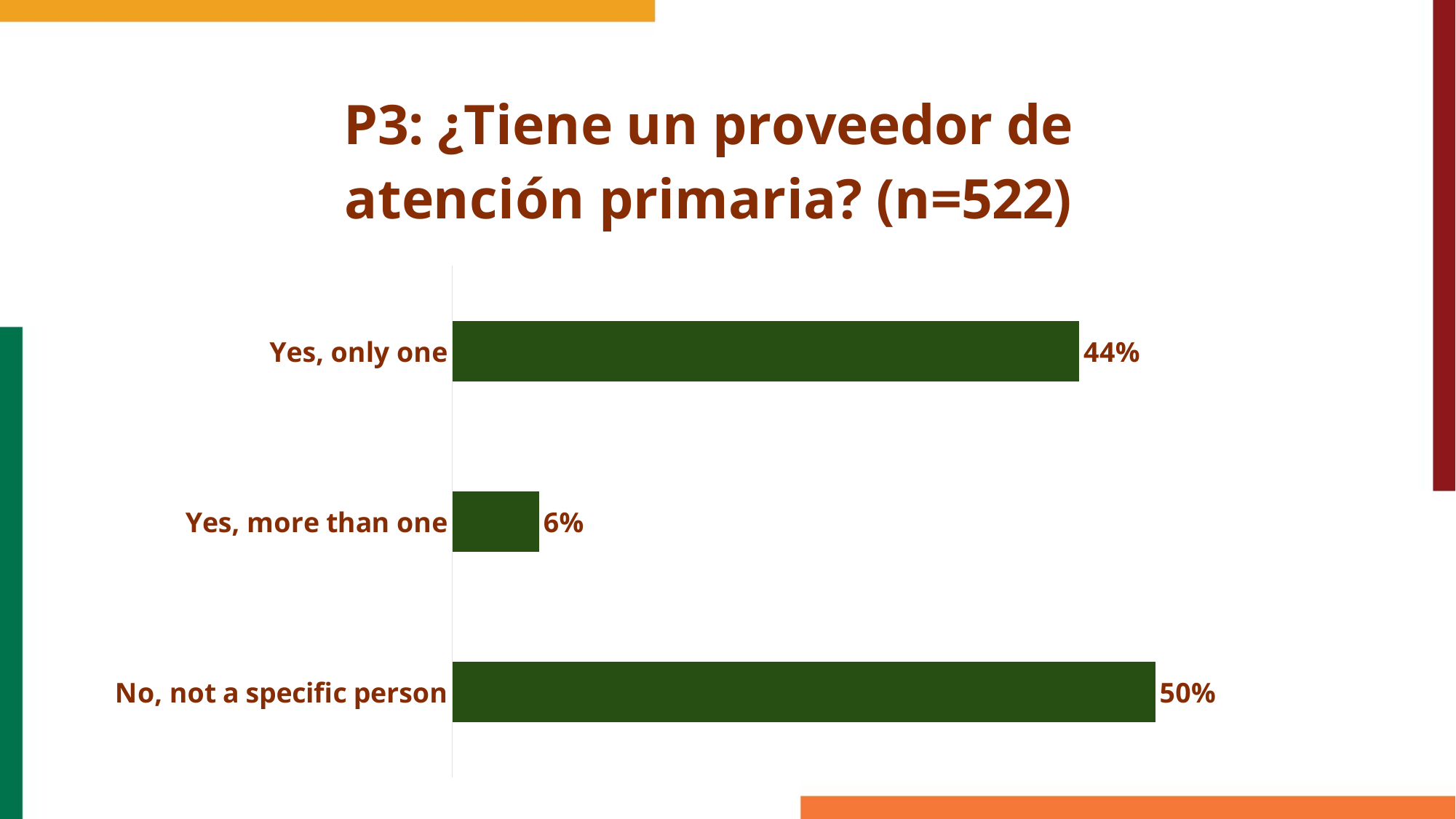
What is the sample size (n) given in the chart title? 522 What is the value for "Yes, only one"? 44% What is the value for "Yes, more than one"? 6% What is the value for "No, not a specific person"? 50% What kind of chart is shown on the slide? Bar chart How many categories are shown in the chart? 3 Which category has the highest value? No, not a specific person What is the difference between the values for "Yes, only one" and "Yes, more than one"? 38% What is the difference between the values for "No, not a specific person" and "Yes, only one"? 6% Which is larger, the value for "Yes, only one" or the value for "Yes, more than one"? Yes, only one Which category has the lowest value? Yes, more than one What is the title of the chart? P3: ¿Tiene un proveedor de atención primaria? (n=522)